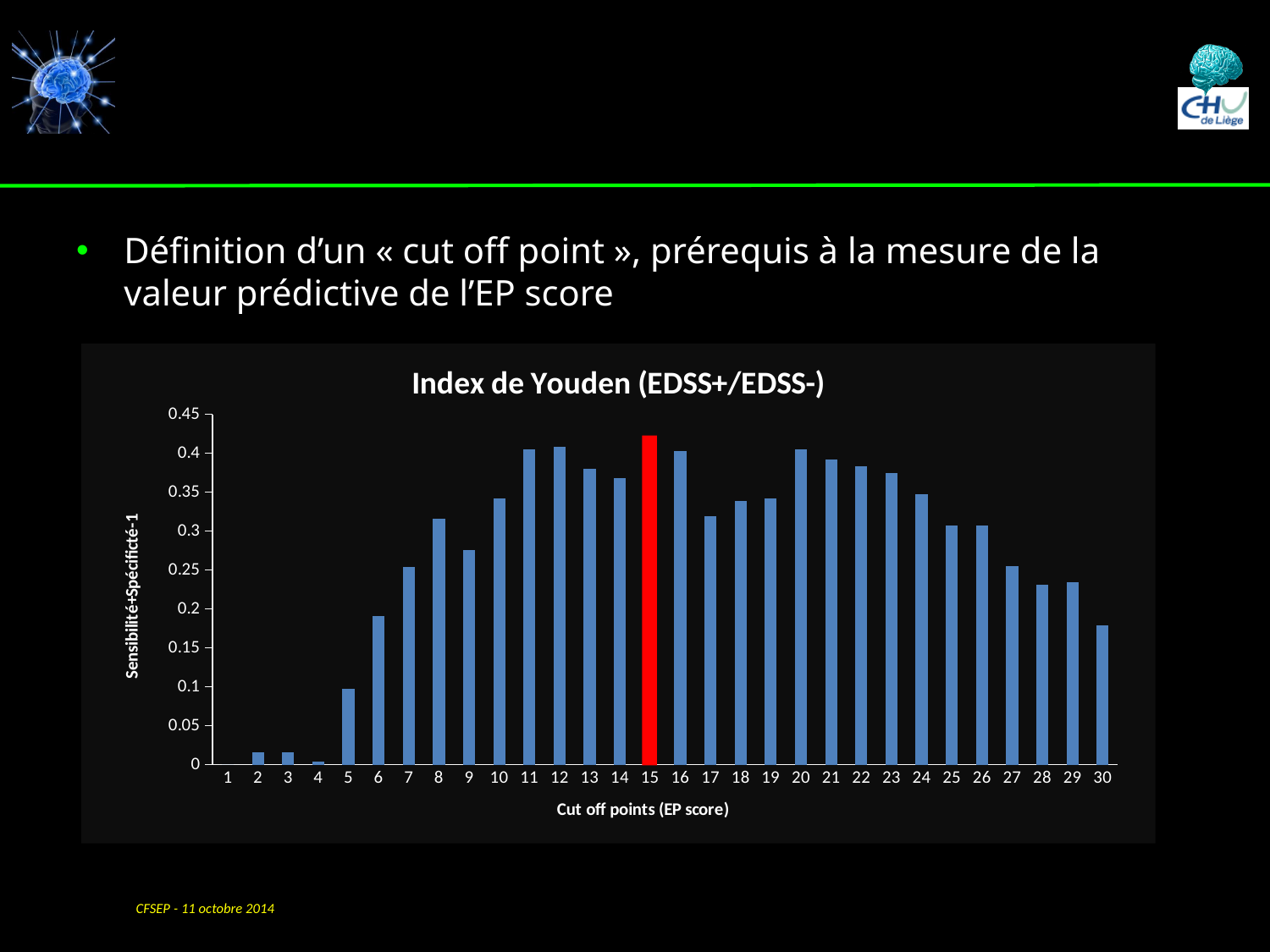
Is the value for cut off point 2 greater or less than 0.05? less Is the value for cut off point 13 greater or less than 0.4? less Is the value for cut off point 15 greater or less than 0.4? greater Which cut off point has the highest value? 15 What is the title of the chart? Index de Youden (EDSS+/EDSS-) How many cut off points are plotted on the x axis? 30 What kind of chart is shown on the slide? bar chart Which has the larger value, cut off point 7 or cut off point 8? 8 Which cut off point is highlighted with a red bar? 15 Do the values rise or fall from cut off point 1 to cut off point 15? rise